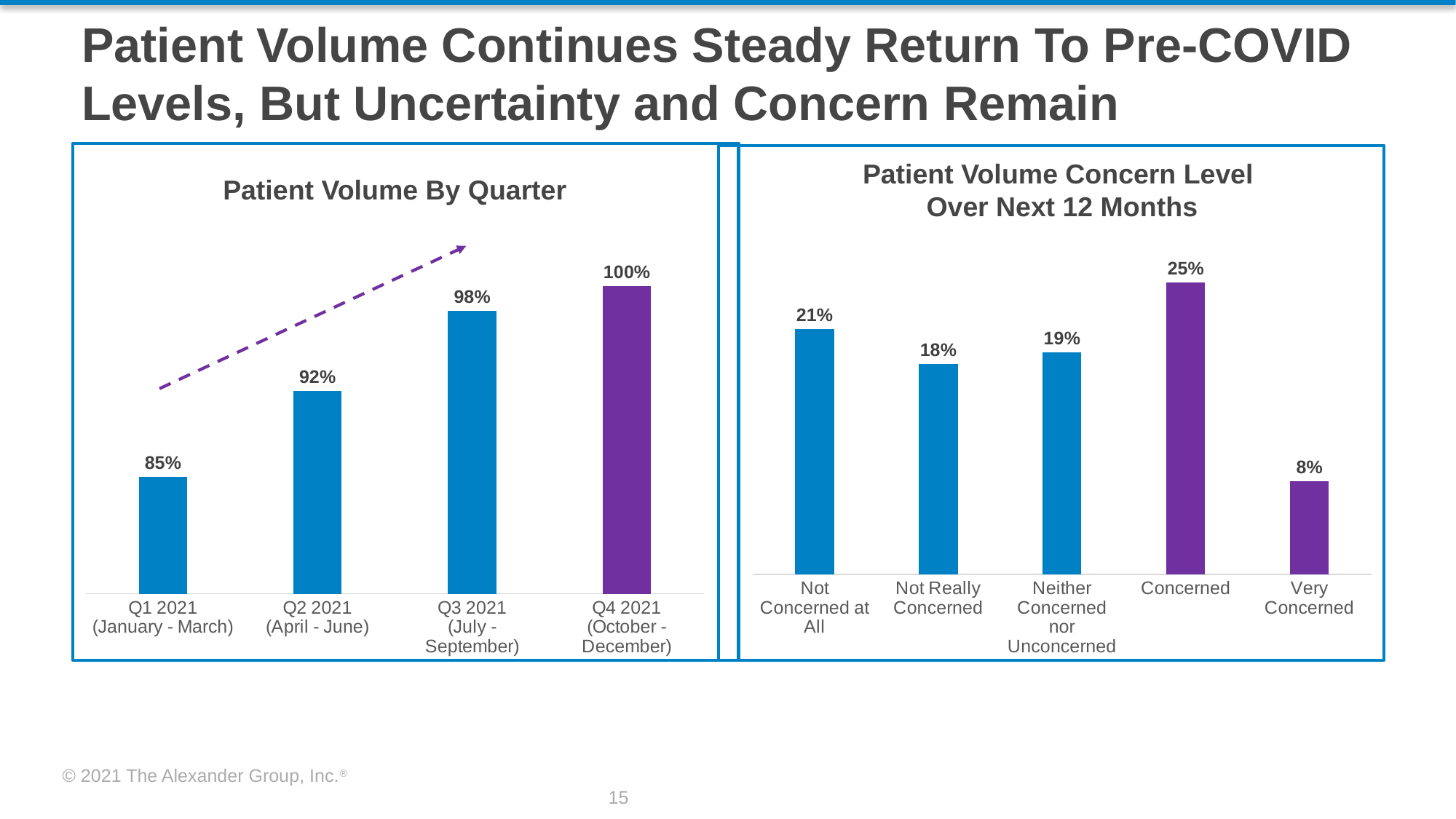
In the 'Patient Volume By Quarter' chart, how many quarters are shown? 4 In the 'Patient Volume By Quarter' chart, what is the value for Q1 2021? 85% What kind of chart is the 'Patient Volume Concern Level Over Next 12 Months' chart? bar chart In the 'Patient Volume By Quarter' chart, which quarter has the highest value? Q4 2021 In the 'Patient Volume Concern Level Over Next 12 Months' chart, what is the difference between 'Concerned' and 'Neither Concerned nor Unconcerned'? 6% In the 'Patient Volume Concern Level Over Next 12 Months' chart, what is the value for 'Concerned'? 25% In the 'Patient Volume Concern Level Over Next 12 Months' chart, which category has the lowest value? Very Concerned In the 'Patient Volume By Quarter' chart, what is the difference between Q4 2021 and Q1 2021? 15% In the 'Patient Volume By Quarter' chart, do the values rise or fall from Q1 2021 to Q4 2021? rise In the 'Patient Volume Concern Level Over Next 12 Months' chart, which is larger: 'Not Concerned at All' or 'Not Really Concerned'? Not Concerned at All In the 'Patient Volume By Quarter' chart, what is the value for Q3 2021? 98% In the 'Patient Volume Concern Level Over Next 12 Months' chart, what is the value for 'Very Concerned'? 8%